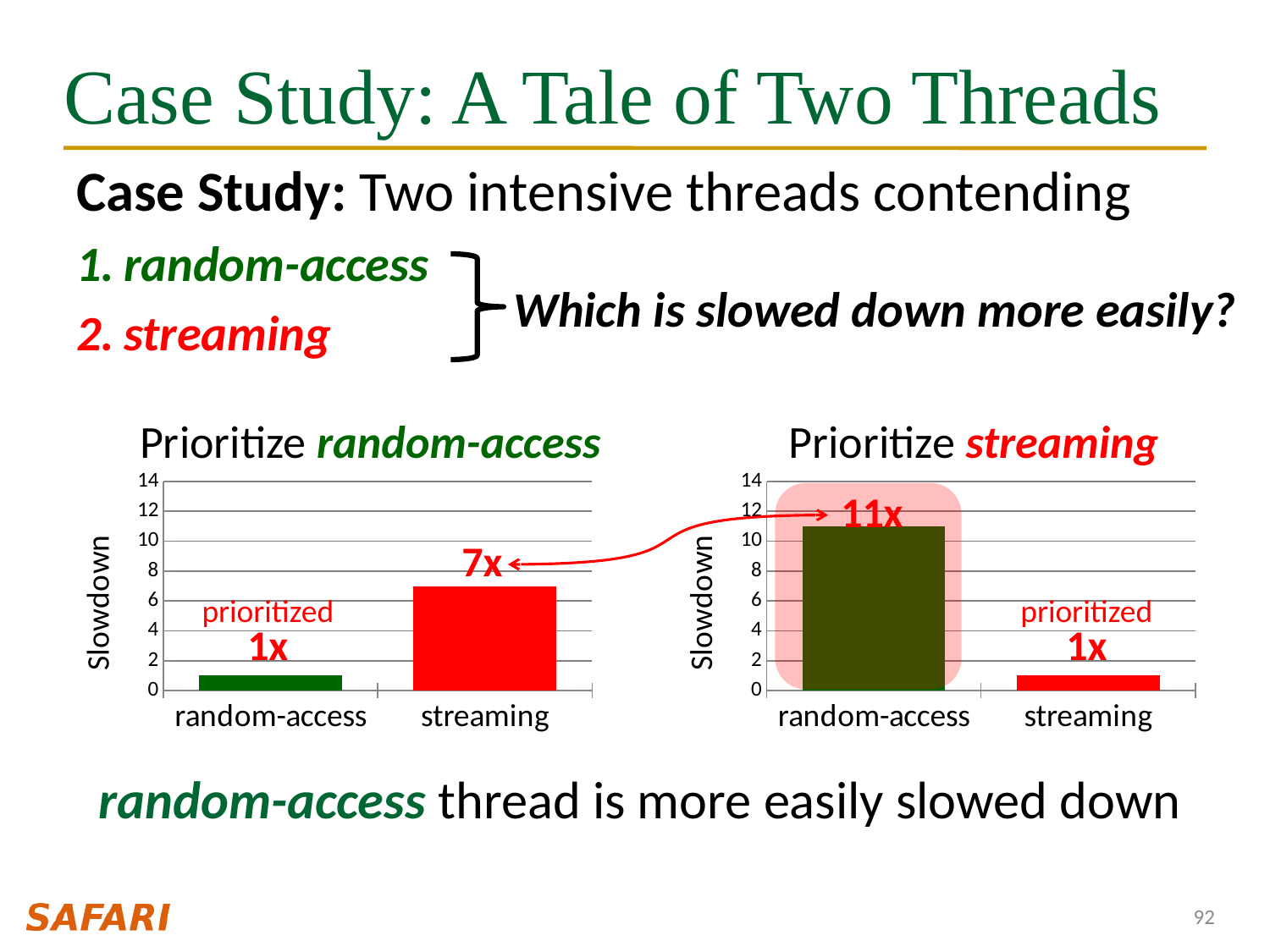
How many categories are shown on the x axis of the 'Prioritize random-access' chart? 2 In the 'Prioritize random-access' chart, what is the slowdown for the streaming thread? 7x In the 'Prioritize random-access' chart, which thread has the lowest slowdown? random-access Which is larger: the slowdown of the streaming thread in the 'Prioritize random-access' chart or the slowdown of the random-access thread in the 'Prioritize streaming' chart? random-access thread in the 'Prioritize streaming' chart In the 'Prioritize streaming' chart, which thread has the highest slowdown? random-access What type of chart is the 'Prioritize streaming' chart? bar chart In the 'Prioritize streaming' chart, what is the slowdown for the random-access thread? 11x In the 'Prioritize streaming' chart, is the slowdown for the random-access thread greater or less than 10? greater In the 'Prioritize streaming' chart, what is the slowdown for the streaming thread? 1x In the 'Prioritize random-access' chart, what is the slowdown for the random-access thread? 1x In the 'Prioritize streaming' chart, what is the difference in slowdown between the random-access and streaming threads? 10x In the 'Prioritize random-access' chart, what is the difference in slowdown between the streaming and random-access threads? 6x